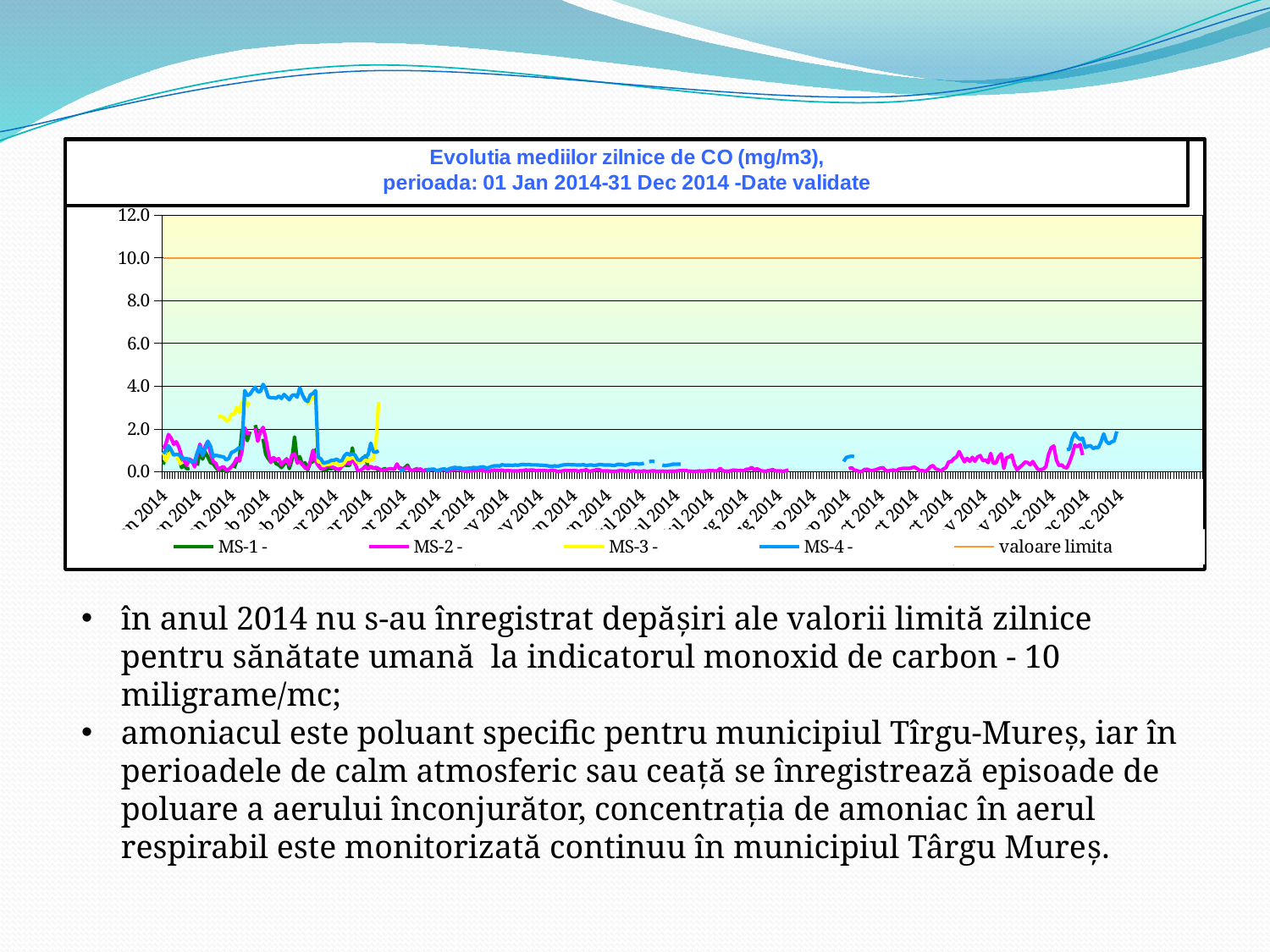
Do any of the MS series rise above the 'valoare limita' line during 2014? No Is the 'valoare limita' line greater or less than 8.0? greater What is the maximum value shown on the y axis? 12.0 How many series does the chart legend list? 5 Which series reaches a higher peak value, MS-4 or MS-1? MS-4 Is the highest value reached by MS-4 greater or less than 6.0? less What kind of chart is shown on the slide? line chart What is the title of the chart? Evolutia mediilor zilnice de CO (mg/m3), perioada: 01 Jan 2014-31 Dec 2014 -Date validate Is the highest value reached by MS-4 greater or less than 2.0? greater Which legend entry is drawn in orange? valoare limita At what value on the y axis does the 'valoare limita' line sit? 10.0